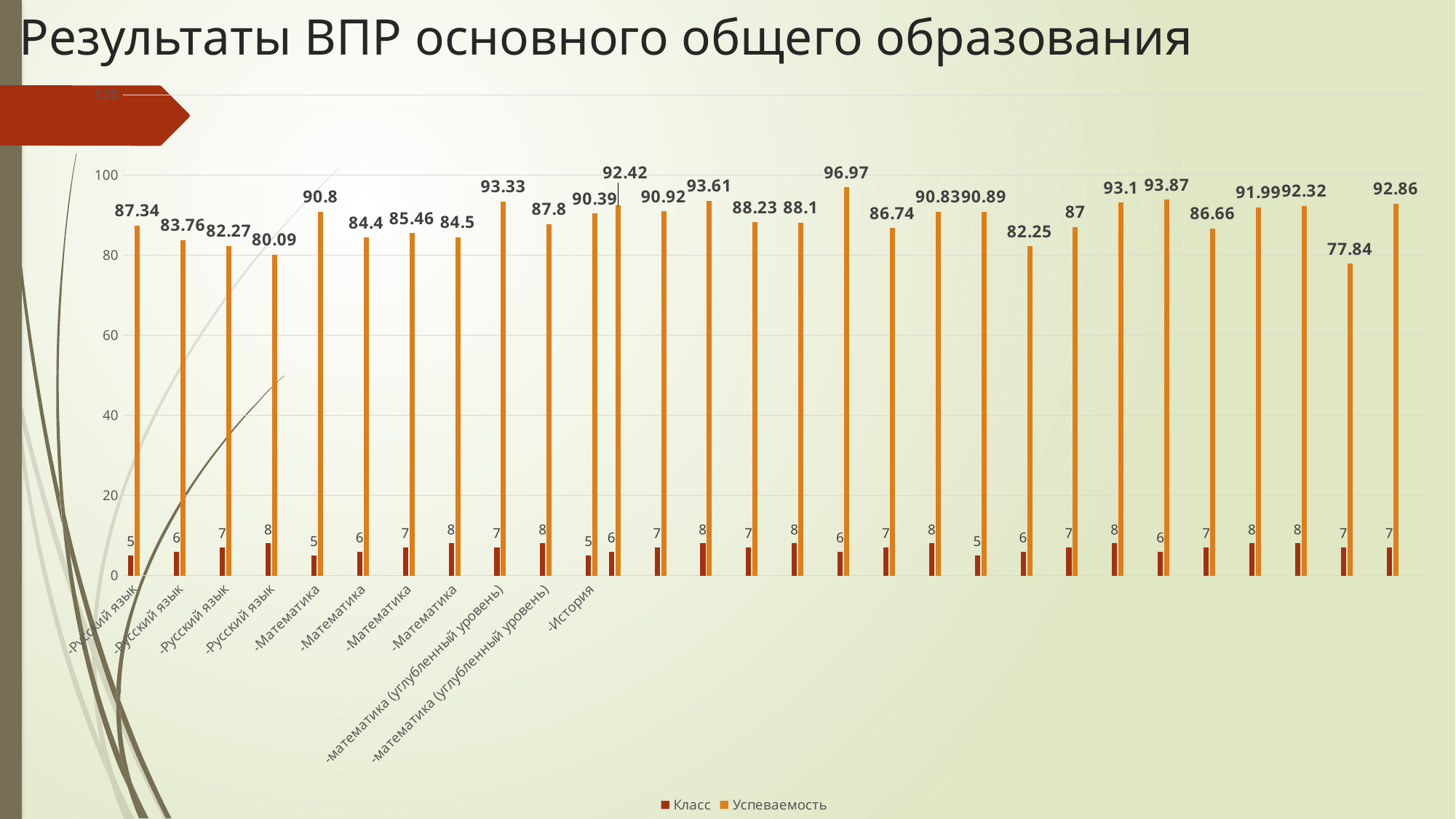
How many series does the chart legend list? 2 What is the Успеваемость value for История in класс 5? 90.39 What is the highest Успеваемость value shown on the chart? 96.97 What is the Успеваемость value for Математика in класс 5? 90.8 Which has the higher Успеваемость value in класс 5: Русский язык or Математика? Математика What is the Успеваемость value for Русский язык in класс 8? 80.09 What is the Успеваемость value for математика (углубленный уровень) in класс 7? 93.33 What is the Успеваемость value for Русский язык in класс 5? 87.34 What is the difference between the Успеваемость values for Русский язык in класс 5 and in класс 8? 7.25 What is the lowest Успеваемость value shown on the chart? 77.84 What are the two series named in the legend? Класс and Успеваемость What type of chart is shown on the slide? bar chart